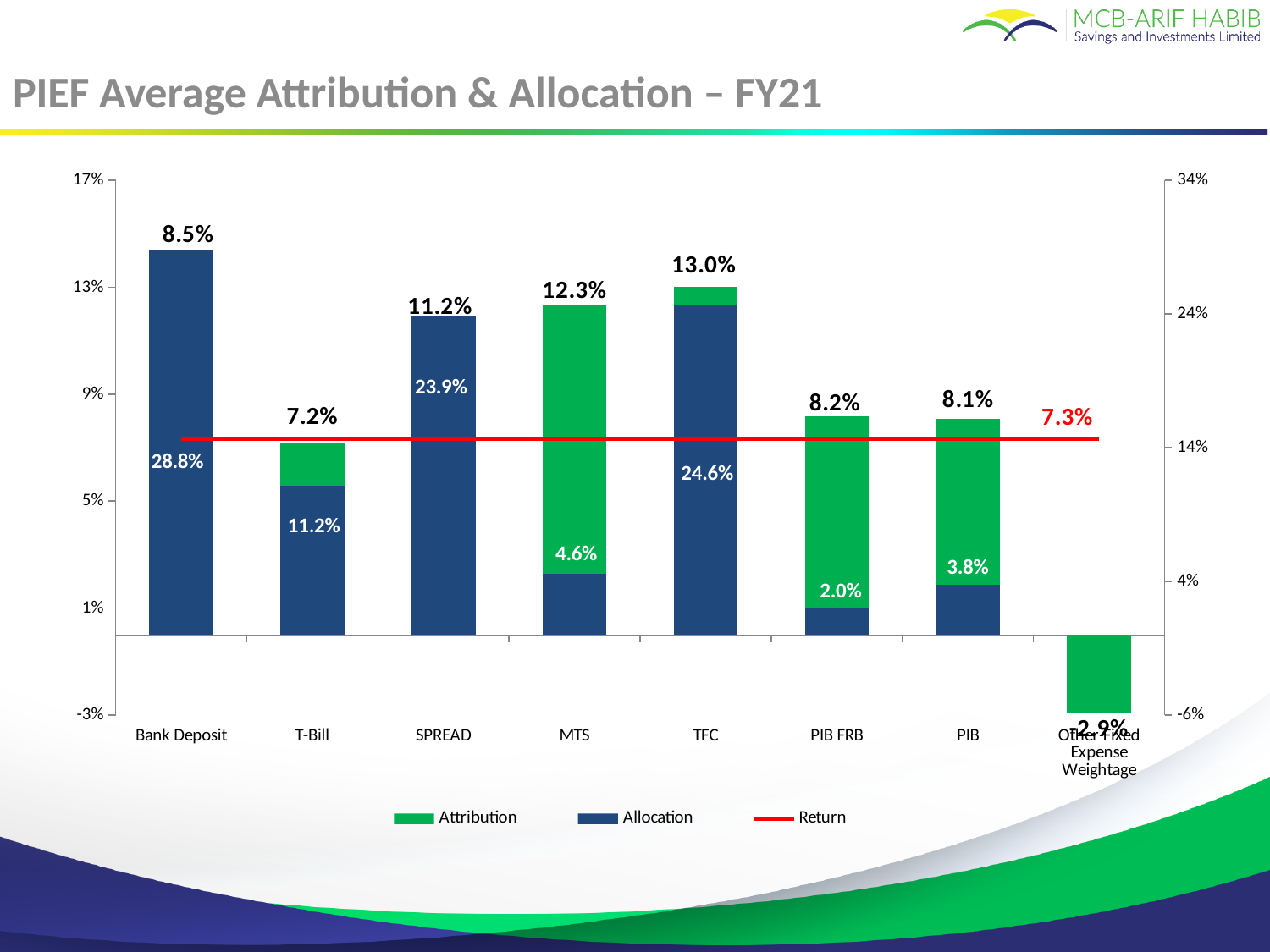
What is the Attribution value for TFC? 13.0% Which has a larger Attribution value, SPREAD or T-Bill? SPREAD What value is shown for the Return line? 7.3% What is the Allocation value for SPREAD? 23.9% Which category has the highest Attribution value? TFC How many series does the legend list? 3 What kind of chart is this? Bar chart with a line What is the Allocation value for Bank Deposit? 28.8% Which category has the lowest Allocation value among those labelled? PIB FRB How many categories are shown on the x axis? 8 What is the Attribution value for Other Fixed Expense Weightage? -2.9% What is the difference between the Attribution values for TFC and MTS? 0.7%